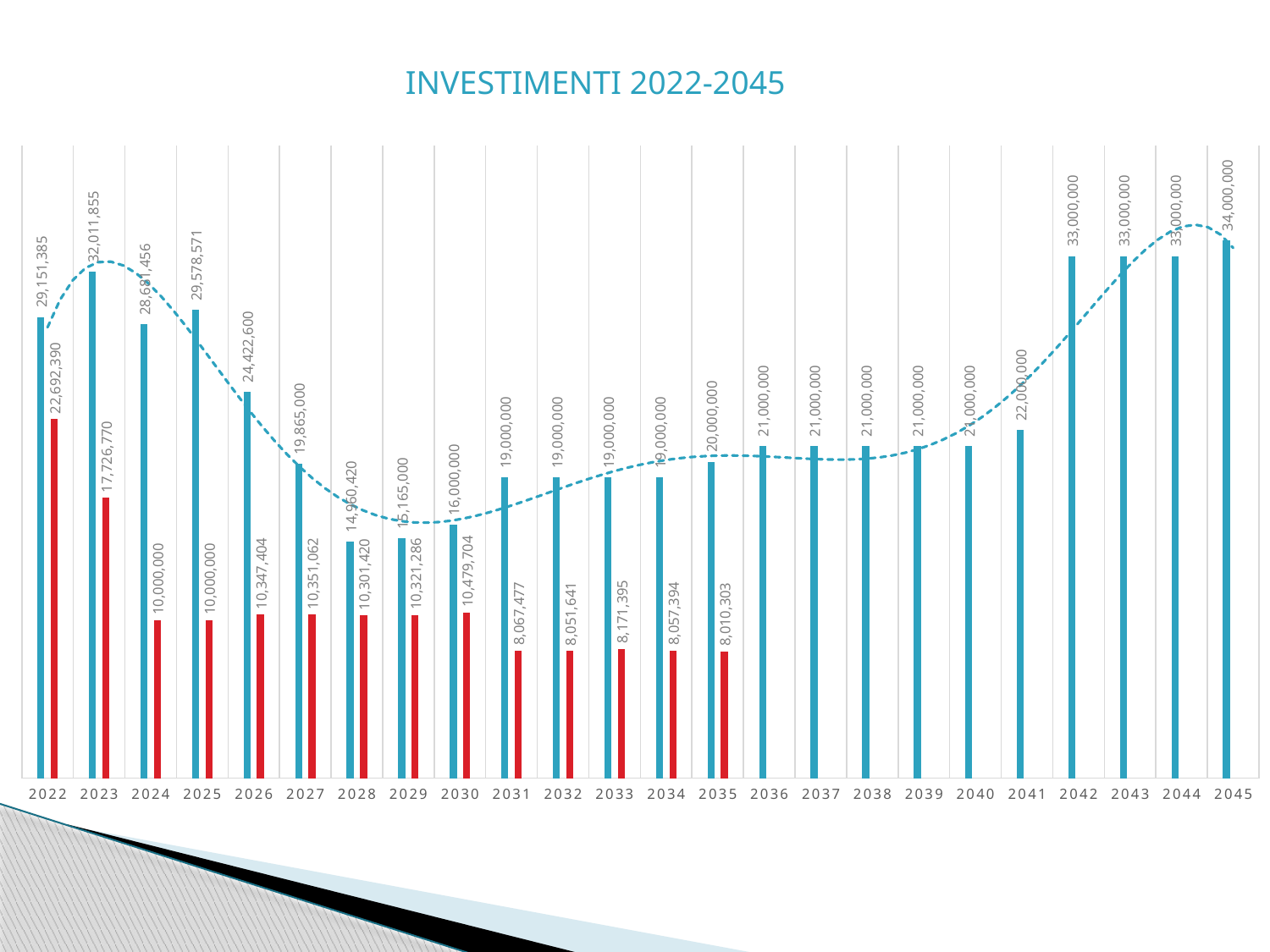
How many years have a red bar? 14 For 2022, which is larger: the blue bar or the red bar? The blue bar Which year has the highest blue bar? 2045 What is the value of the blue bar for 2023? 32,011,855 What is the value of the blue bar for 2041? 22,000,000 What is the value of the red bar for 2022? 22,692,390 Which year has the lowest red bar? 2035 What is the value of the red bar for 2030? 10,479,704 What kind of chart is this? Bar chart What is the difference between the blue bar values for 2045 and 2042? 1,000,000 Do the blue bar values rise or fall from 2041 to 2045? Rise How many years are shown on the x axis? 24